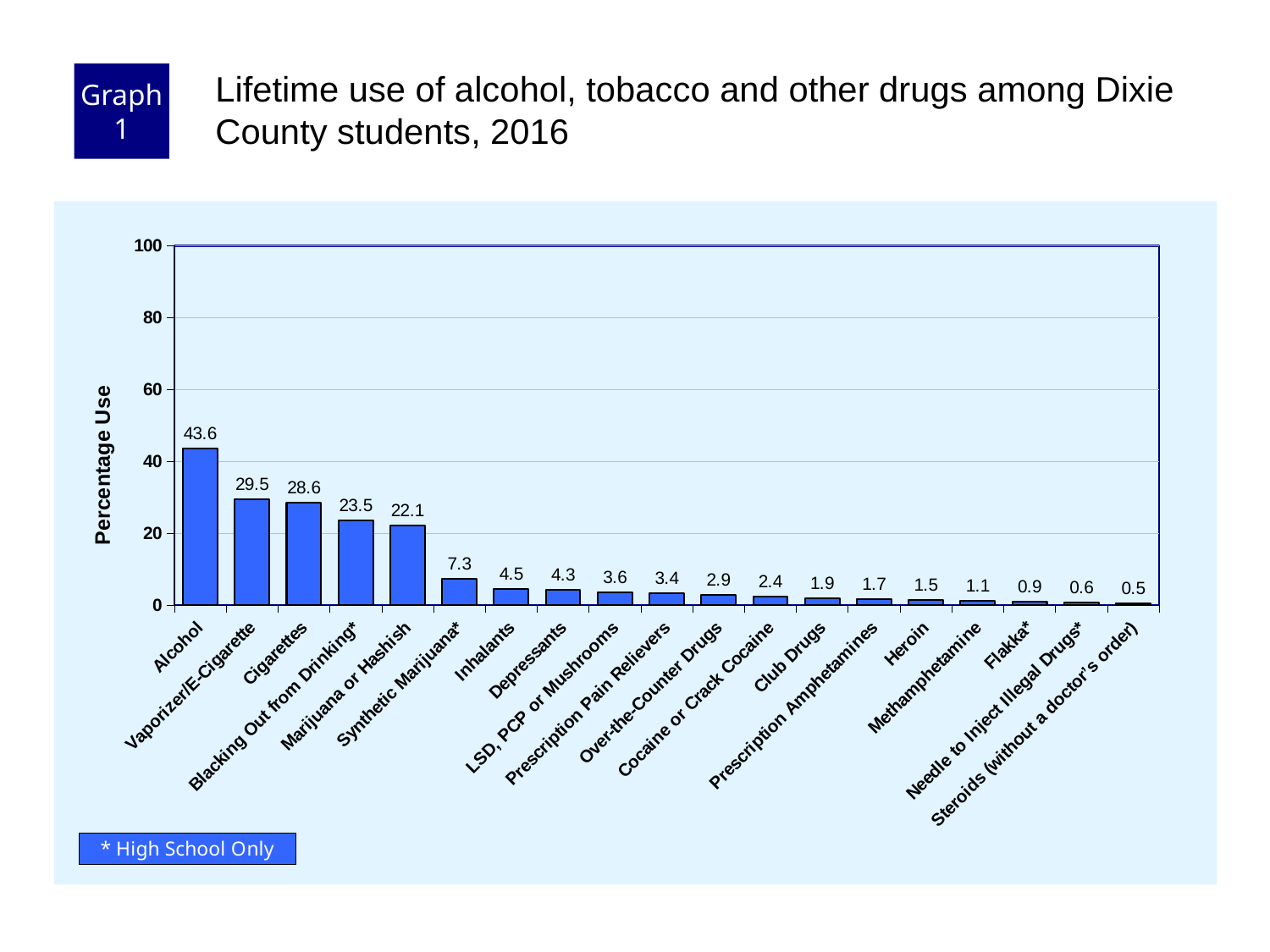
What is the label of the y axis? Percentage Use What is the value for Alcohol? 43.6 What is the difference between the values for Alcohol and Cigarettes? 15 Which is larger, the value for Inhalants or the value for Synthetic Marijuana*? Synthetic Marijuana* What is the value for Heroin? 1.5 Is the value for Alcohol greater or less than 40? greater What kind of chart is shown on the slide? bar chart What is the value for Marijuana or Hashish? 22.1 How many categories are shown on the chart? 19 Which category has the lowest value? Steroids (without a doctor's order) Which category has the highest value? Alcohol What is the difference between the values for Vaporizer/E-Cigarette and Blacking Out from Drinking*? 6